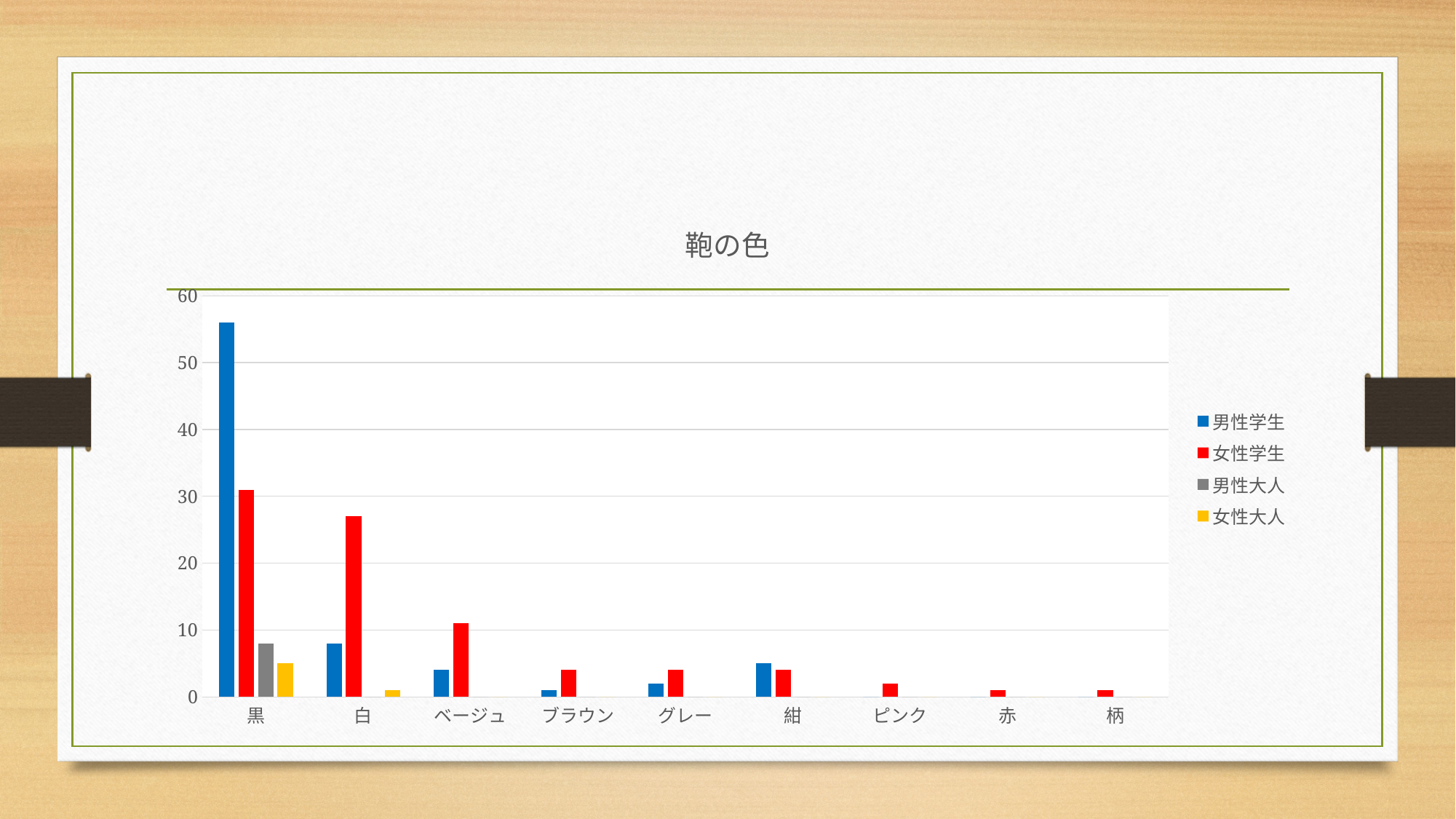
Is the 男性大人 value for 黒 greater or less than 10? less Is the 男性学生 value for 黒 greater or less than 50? greater Which category has the highest 女性学生 value? 黒 What is the title of the chart? 鞄の色 How many series does the legend list? 4 Which category has the highest 男性学生 value? 黒 What kind of chart is shown on the slide? bar chart How many categories are shown on the x axis? 9 Is the 女性学生 value for 白 greater or less than 20? greater For 白, which is larger: 男性学生 or 女性学生? 女性学生 For 黒, which is larger: 男性学生 or 女性学生? 男性学生